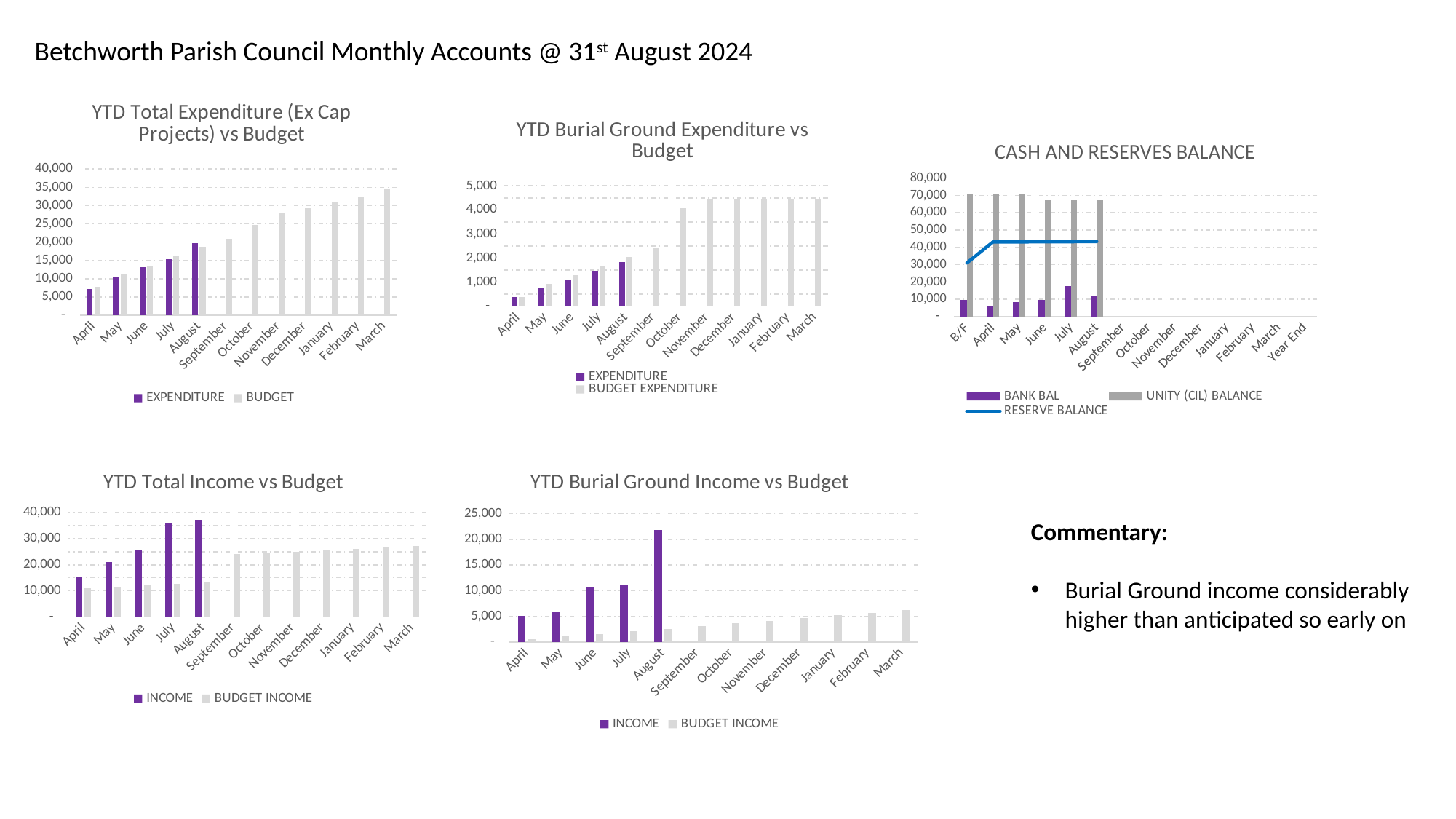
In the 'YTD Burial Ground Income vs Budget' chart, which month has the highest INCOME? August In the 'CASH AND RESERVES BALANCE' chart, how many series does the legend list? 3 In the 'YTD Total Expenditure (Ex Cap Projects) vs Budget' chart, how many series does the legend list? 2 In the 'CASH AND RESERVES BALANCE' chart, which month has the highest BANK BAL? July In the 'YTD Burial Ground Income vs Budget' chart, is the INCOME value for August greater or less than 20,000? greater In the 'CASH AND RESERVES BALANCE' chart, is the UNITY (CIL) BALANCE for B/F greater or less than 60,000? greater In the 'YTD Total Expenditure (Ex Cap Projects) vs Budget' chart, what kind of chart is shown? Bar chart In the 'YTD Burial Ground Expenditure vs Budget' chart, how many months are shown on the x axis? 12 In the 'YTD Total Income vs Budget' chart, does INCOME rise or fall from April to August? Rise In the 'YTD Burial Ground Expenditure vs Budget' chart, is the EXPENDITURE value for August greater or less than 1,000? greater In the 'YTD Total Income vs Budget' chart, which is larger for August: INCOME or BUDGET INCOME? INCOME